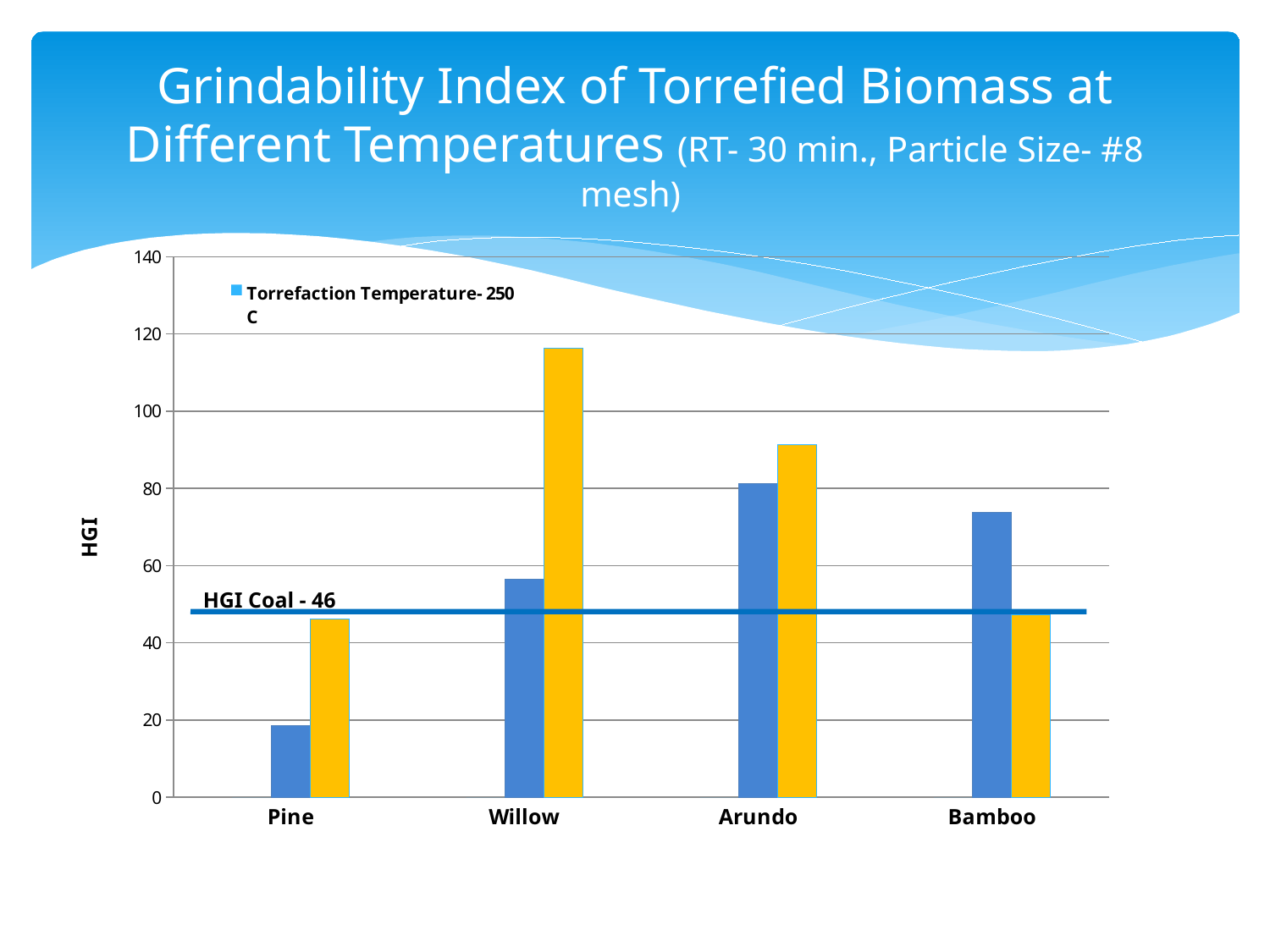
How many series does the legend list? 1 For Bamboo, which bar is taller, the blue bar or the yellow bar? blue bar Which category has the lowest blue (Torrefaction Temperature- 250 C) bar? Pine What is the HGI value of coal marked by the horizontal reference line? 46 How many biomass categories are shown on the x axis? 4 What is the label on the y axis? HGI Is the yellow bar for Arundo greater or less than 80? greater What kind of chart is shown on the slide? bar chart Which category has the highest blue (Torrefaction Temperature- 250 C) bar? Arundo Which category has the highest yellow bar? Willow Is the yellow bar for Willow greater or less than 100? greater